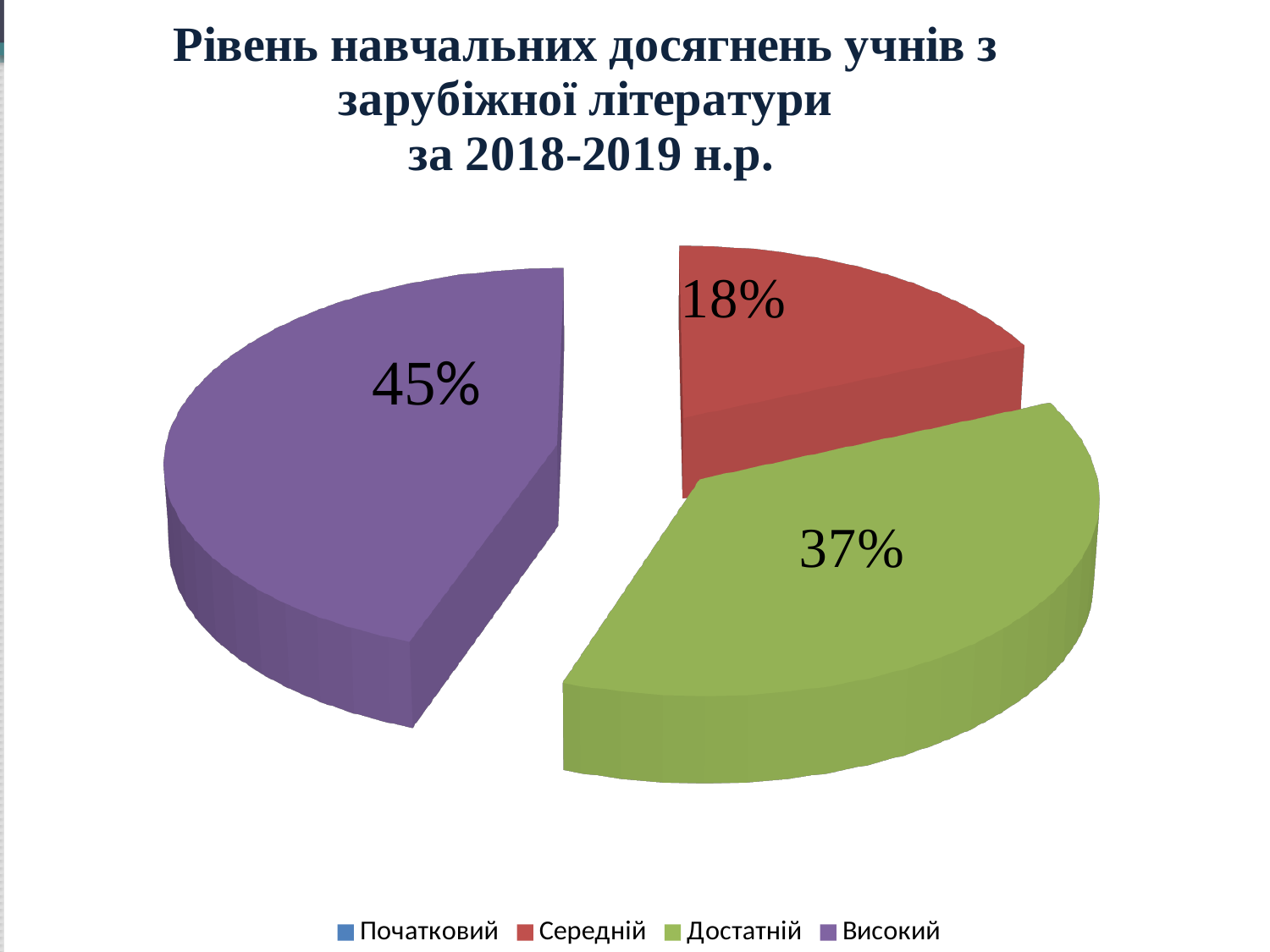
What is the difference in percentage points between the Високий and Середній slices? 27 What kind of chart is shown on the slide? pie chart What percentage is shown for the Високий level? 45% Of the slices shown in the pie, which level has the smallest share? Середній How many slices are visible in the pie? 3 How many entries does the legend list? 4 What colour is the slice for the Достатній level? green What percentage is shown for the Середній level? 18% What is the difference in percentage points between the Високий and Достатній slices? 8 Which is larger, the share for Достатній or the share for Середній? Достатній What percentage is shown for the Достатній level? 37% Which level has the largest share of the pie? Високий